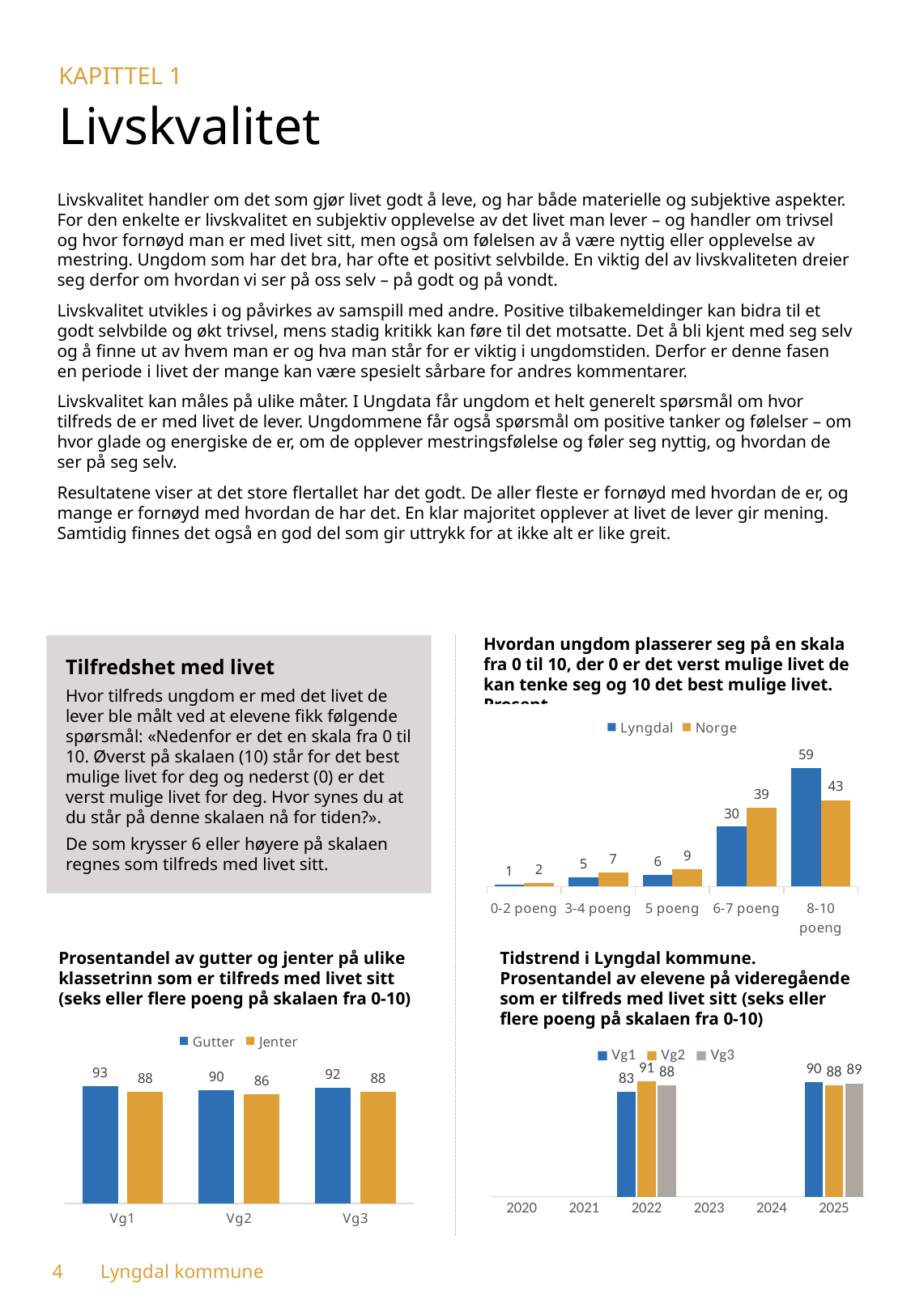
In the bottom-right chart (Tidstrend i Lyngdal kommune), what is the value for Vg1 in 2022? 83 In the top-right chart (Hvordan ungdom plasserer seg på en skala fra 0 til 10), what is the value for Lyngdal in the 8-10 poeng category? 59 What kind of chart is the bottom-right chart (Tidstrend i Lyngdal kommune)? Bar chart In the bottom-right chart (Tidstrend i Lyngdal kommune), which series has the highest value in 2025? Vg1 In the top-right chart (Hvordan ungdom plasserer seg på en skala fra 0 til 10), which category has the highest value for Lyngdal? 8-10 poeng In the bottom-left chart (Prosentandel av gutter og jenter på ulike klassetrinn som er tilfreds med livet sitt), what is the difference between Gutter and Jenter at Vg1? 5 In the top-right chart (Hvordan ungdom plasserer seg på en skala fra 0 til 10), what is the difference between Lyngdal and Norge in the 8-10 poeng category? 16 In the bottom-left chart (Prosentandel av gutter og jenter på ulike klassetrinn som er tilfreds med livet sitt), which is larger at Vg1: Gutter or Jenter? Gutter In the bottom-left chart (Prosentandel av gutter og jenter på ulike klassetrinn som er tilfreds med livet sitt), what is the value for Jenter at Vg2? 86 In the top-right chart (Hvordan ungdom plasserer seg på en skala fra 0 til 10), what is the value for Norge in the 6-7 poeng category? 39 In the bottom-left chart (Prosentandel av gutter og jenter på ulike klassetrinn som er tilfreds med livet sitt), how many series does the legend list? 2 In the top-right chart (Hvordan ungdom plasserer seg på en skala fra 0 til 10), how many categories are shown on the x axis? 5